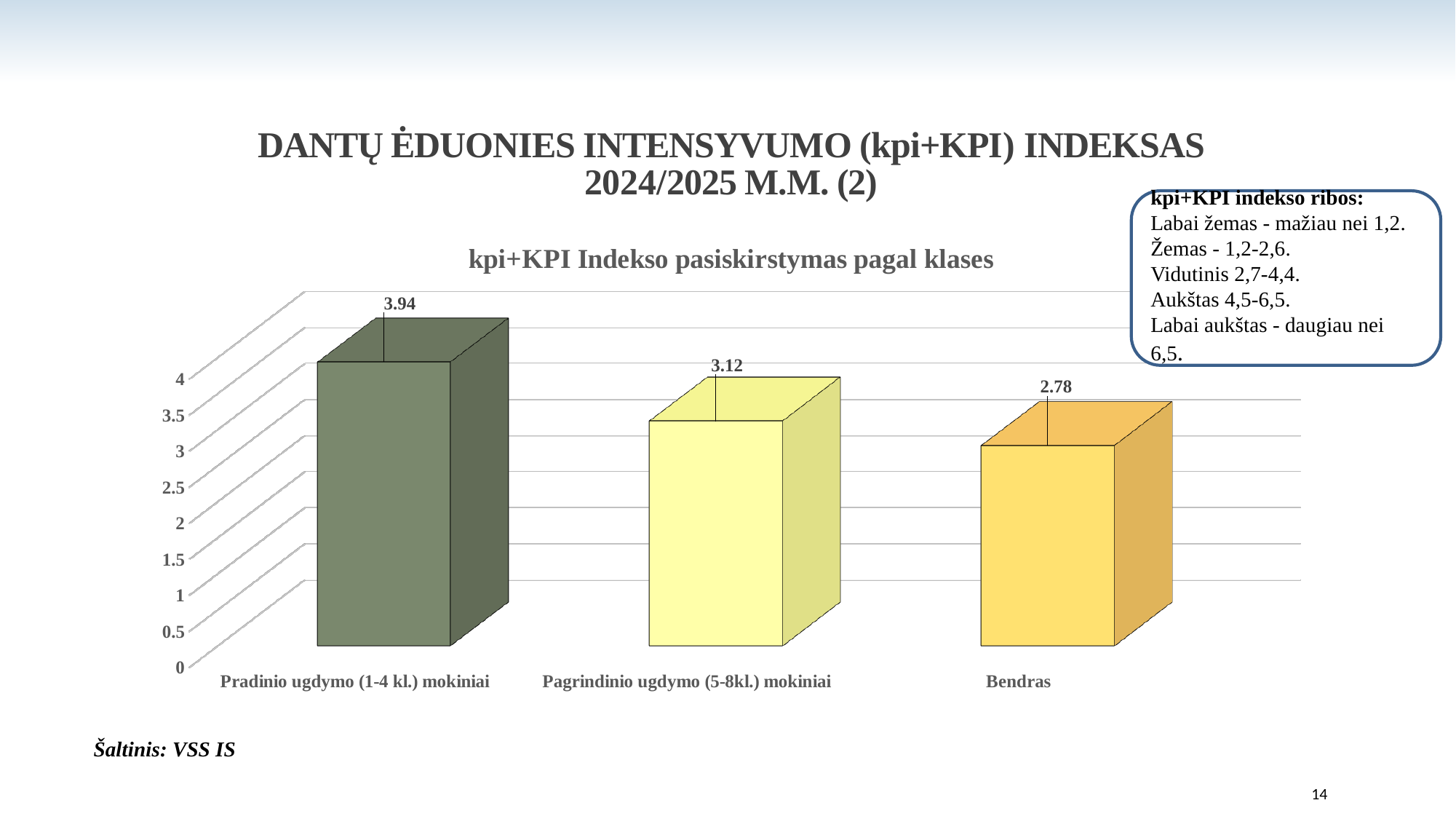
What is the title of the chart? kpi+KPI Indekso pasiskirstymas pagal klases What is the value for Pagrindinio ugdymo (5-8kl.) mokiniai? 3.12 Which category has the highest value? Pradinio ugdymo (1-4 kl.) mokiniai Which category has the lowest value? Bendras What is the difference between the values for Pradinio ugdymo (1-4 kl.) mokiniai and Pagrindinio ugdymo (5-8kl.) mokiniai? 0.82 What is the difference between the values for Pagrindinio ugdymo (5-8kl.) mokiniai and Bendras? 0.34 Which is larger, the value for Pagrindinio ugdymo (5-8kl.) mokiniai or the value for Bendras? Pagrindinio ugdymo (5-8kl.) mokiniai What is the value for Pradinio ugdymo (1-4 kl.) mokiniai? 3.94 How many categories are shown on the chart? 3 What is the value for Bendras? 2.78 Is the value for Bendras greater or less than 3? less What kind of chart is shown on the slide? bar chart